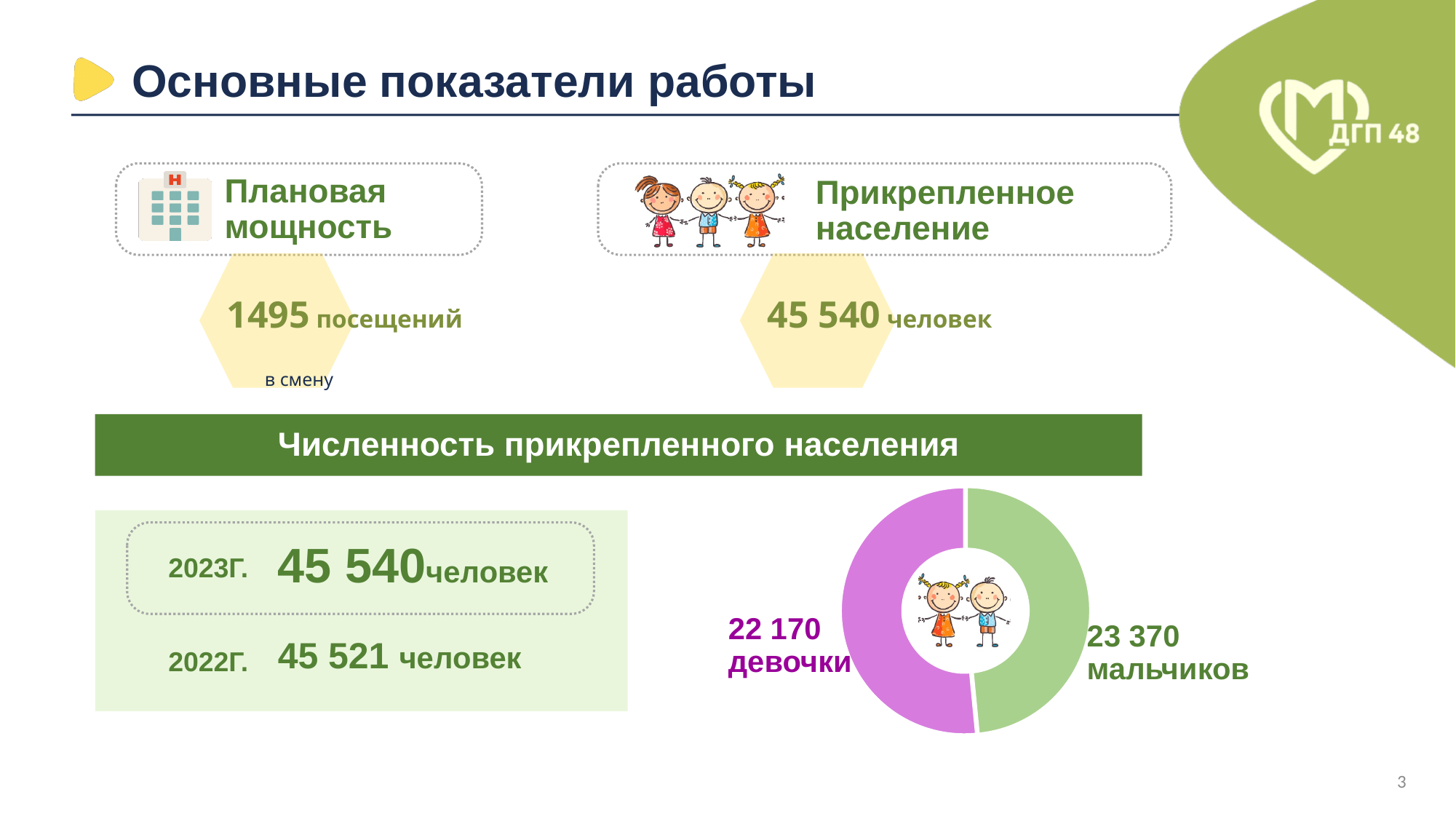
What is the difference between the number of мальчиков and девочки in the donut chart? 1 200 What is the total of the two slices in the donut chart? 45 540 What is the heading above the donut chart section? Численность прикрепленного населения What type of chart is shown on the slide? Donut (pie) chart What is the value for девочки in the donut chart? 22 170 What is the value for мальчиков in the donut chart? 23 370 How many slices does the donut chart have? 2 Which group has the larger slice in the donut chart? мальчиков What share of the donut chart do мальчиков make up? 51.3% Is the value for мальчиков larger or smaller than the value for девочки? larger Which group has the smaller slice in the donut chart? девочки What colour is the девочки slice in the donut chart? Pink (magenta)